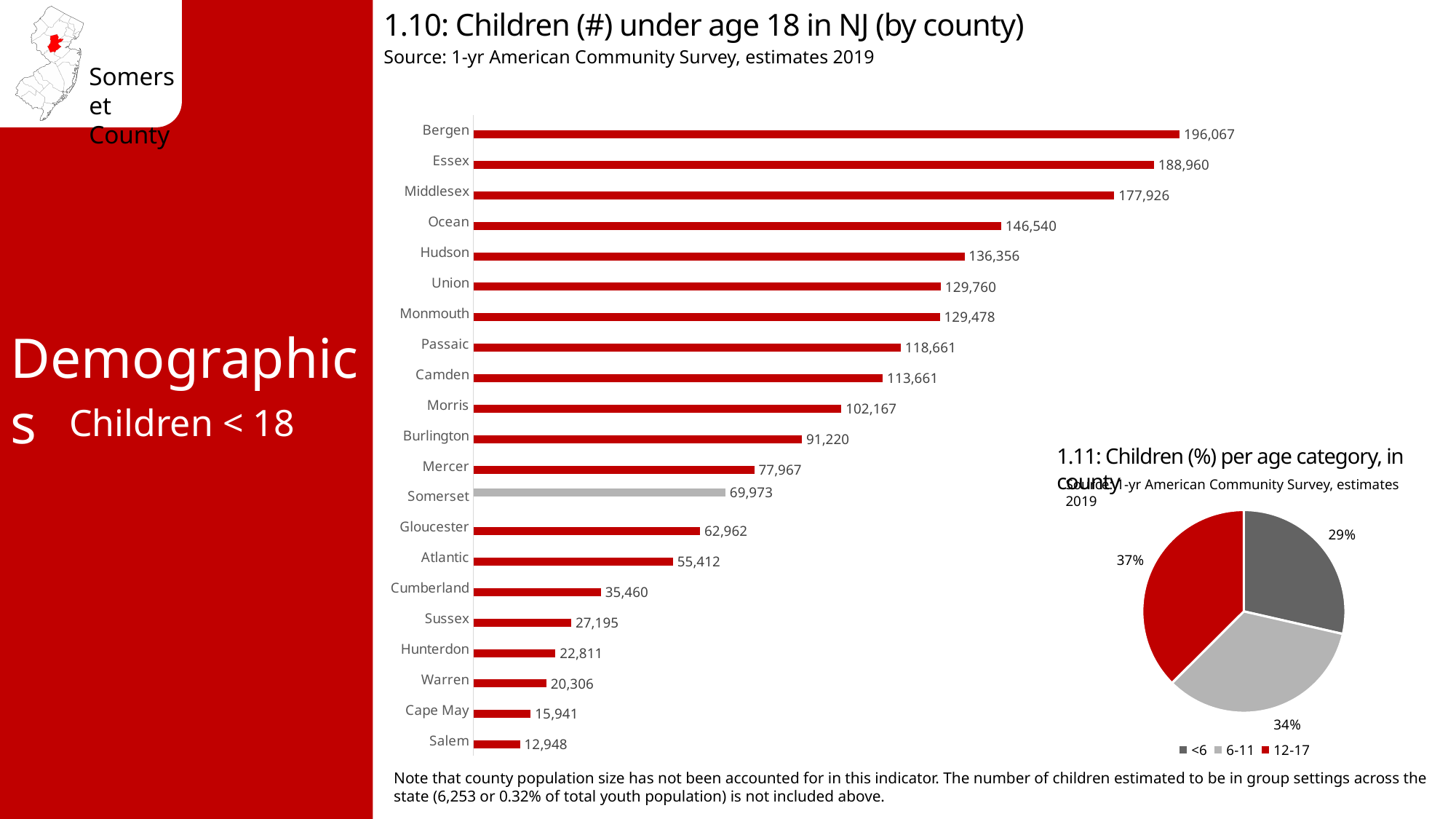
In the bar chart 1.10, which county has the highest number of children under age 18? Bergen In the bar chart 1.10, which bar is coloured grey instead of red? Somerset How many categories does the legend of the pie chart 1.11 list? 3 In the pie chart 1.11, what share of children are in the 6-11 age category? 34% In the bar chart 1.10, which county has more children under 18, Ocean or Hudson? Ocean In the bar chart 1.10, how many counties are shown? 21 In the bar chart 1.10, what is the difference between the values for Bergen and Essex? 7,107 In the pie chart 1.11, which age category has the largest share? 12-17 In the bar chart 1.10, how many children under age 18 are in Somerset County? 69,973 In the bar chart 1.10, what is the value for Cape May? 15,941 What kind of chart is chart 1.10? bar chart In the bar chart 1.10, which county has the lowest number of children under age 18? Salem